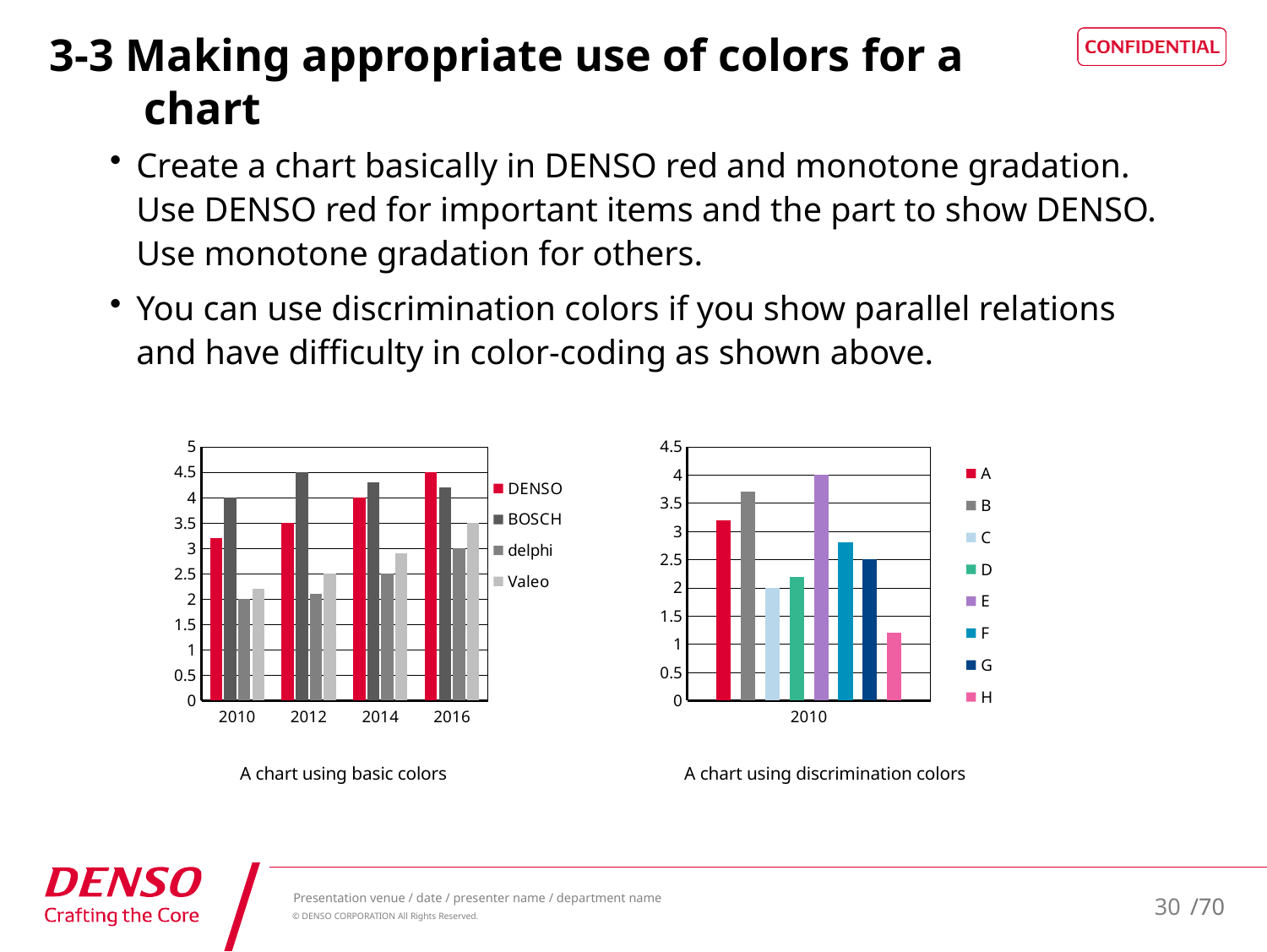
In the chart titled "A chart using basic colors", which series is shown in red? DENSO In the chart titled "A chart using basic colors", which is larger in 2010, DENSO or BOSCH? BOSCH In the chart titled "A chart using basic colors", how many series does the legend list? 4 In the chart titled "A chart using basic colors", is the value for DENSO in 2016 greater or less than 4? greater In the chart titled "A chart using basic colors", is the value for delphi in 2010 greater or less than 2.5? less What kind of chart is the chart titled "A chart using basic colors"? bar chart In the chart titled "A chart using discrimination colors", which series has the highest value? E In the chart titled "A chart using discrimination colors", which series has the lowest value? H In the chart titled "A chart using basic colors", do the DENSO values rise or fall from 2010 to 2016? rise In the chart titled "A chart using discrimination colors", is the value for H greater or less than 1.5? less In the chart titled "A chart using basic colors", how many years are shown on the x axis? 4 In the chart titled "A chart using discrimination colors", how many series does the legend list? 8